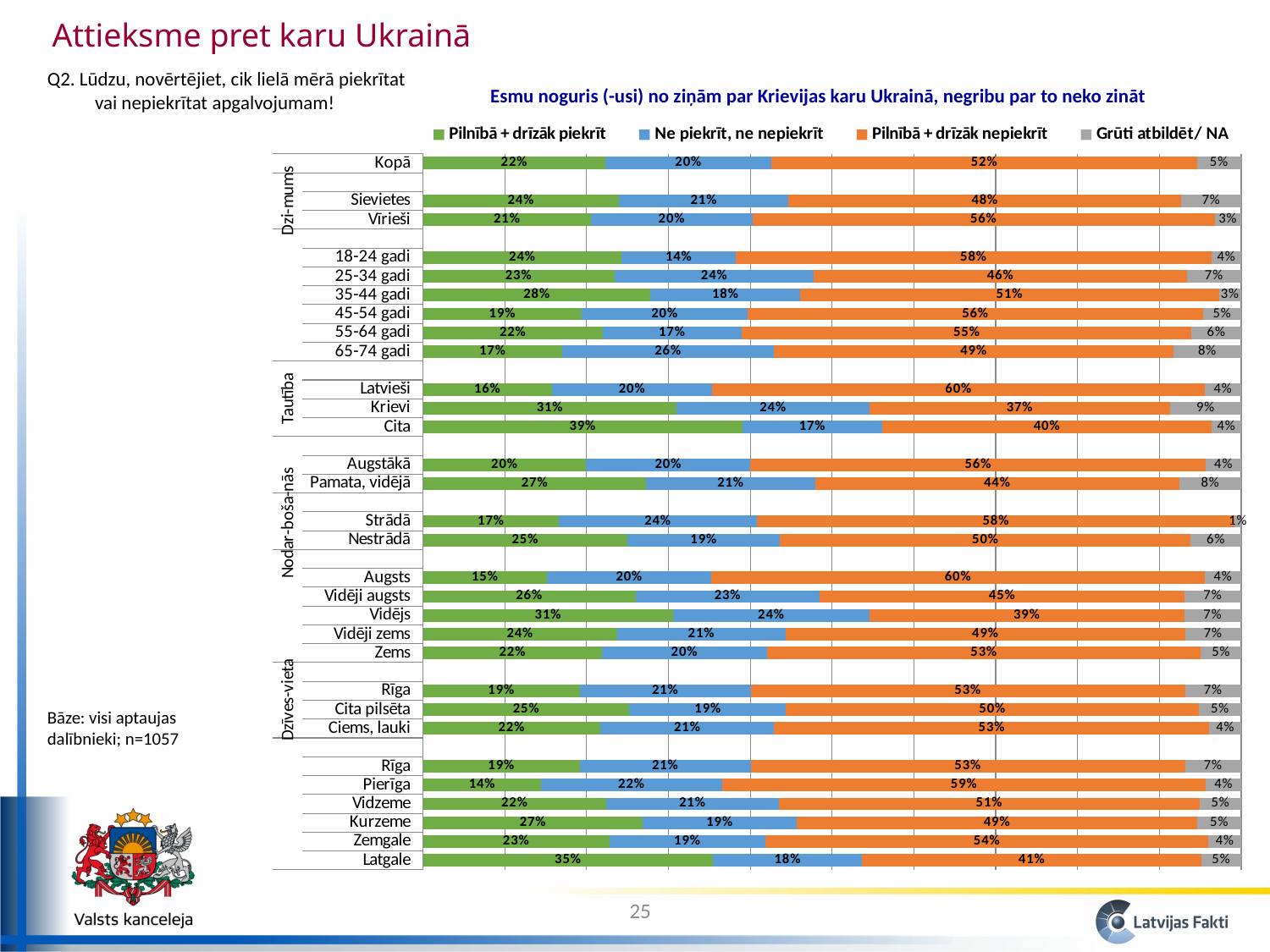
What is the 'Ne piekrīt, ne nepiekrīt' value for Pierīga? 22% What is the total of the four segments in the Strādā bar? 100% What is the difference in percentage points between the 'Pilnībā + drīzāk nepiekrīt' values for Vīrieši and Sievietes? 8 percentage points What is the 'Grūti atbildēt/ NA' value for the Strādā group? 1% What type of chart is shown on the slide? Stacked bar chart What is the 'Pilnībā + drīzāk piekrīt' value for Latgale? 35% Which group has a larger 'Pilnībā + drīzāk piekrīt' share, Krievi or Latvieši? Krievi How many series does the chart legend list? 4 Among the age groups, which has the lowest 'Pilnībā + drīzāk piekrīt' share? 65-74 gadi Among the regions Rīga, Pierīga, Vidzeme, Kurzeme, Zemgale and Latgale, which has the highest 'Pilnībā + drīzāk nepiekrīt' share? Pierīga Among the Tautība groups (Latvieši, Krievi, Cita), which has the highest 'Pilnībā + drīzāk piekrīt' share? Cita What percentage of all respondents (Kopā) fall into the 'Pilnībā + drīzāk nepiekrīt' category? 52%